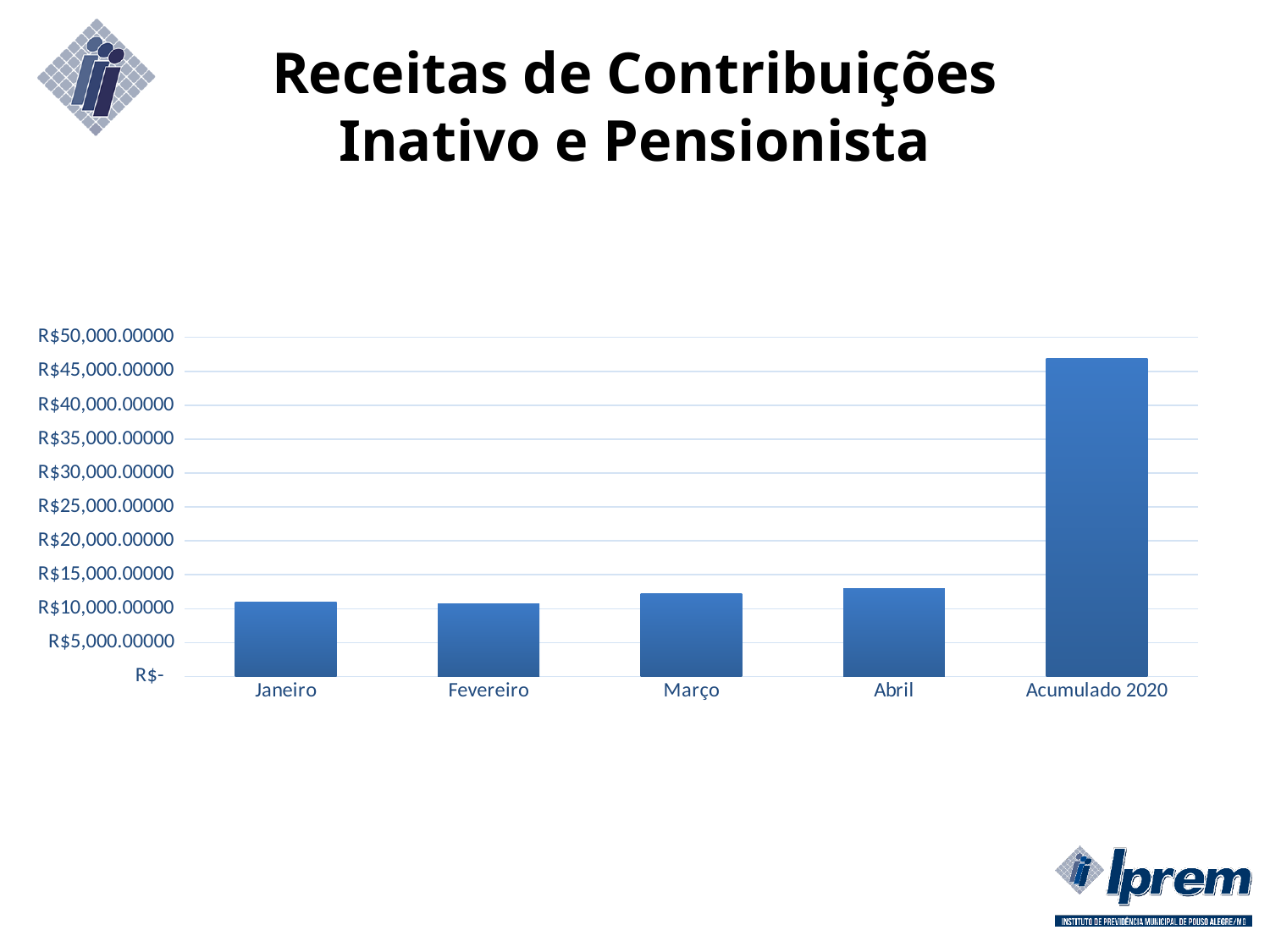
Which is larger, the value for Março or the value for Fevereiro? Março How many categories are plotted on the x axis? 5 Is the value for Março greater or less than R$15,000.00000? less Which is larger, the value for Abril or the value for Janeiro? Abril Which category has the highest value? Acumulado 2020 Is the value for Janeiro greater or less than R$10,000.00000? greater What kind of chart is shown on the slide? bar chart What is the title of the chart on the slide? Receitas de Contribuições Inativo e Pensionista What is the label of the last category on the x axis? Acumulado 2020 Is the value for Abril greater or less than R$15,000.00000? less